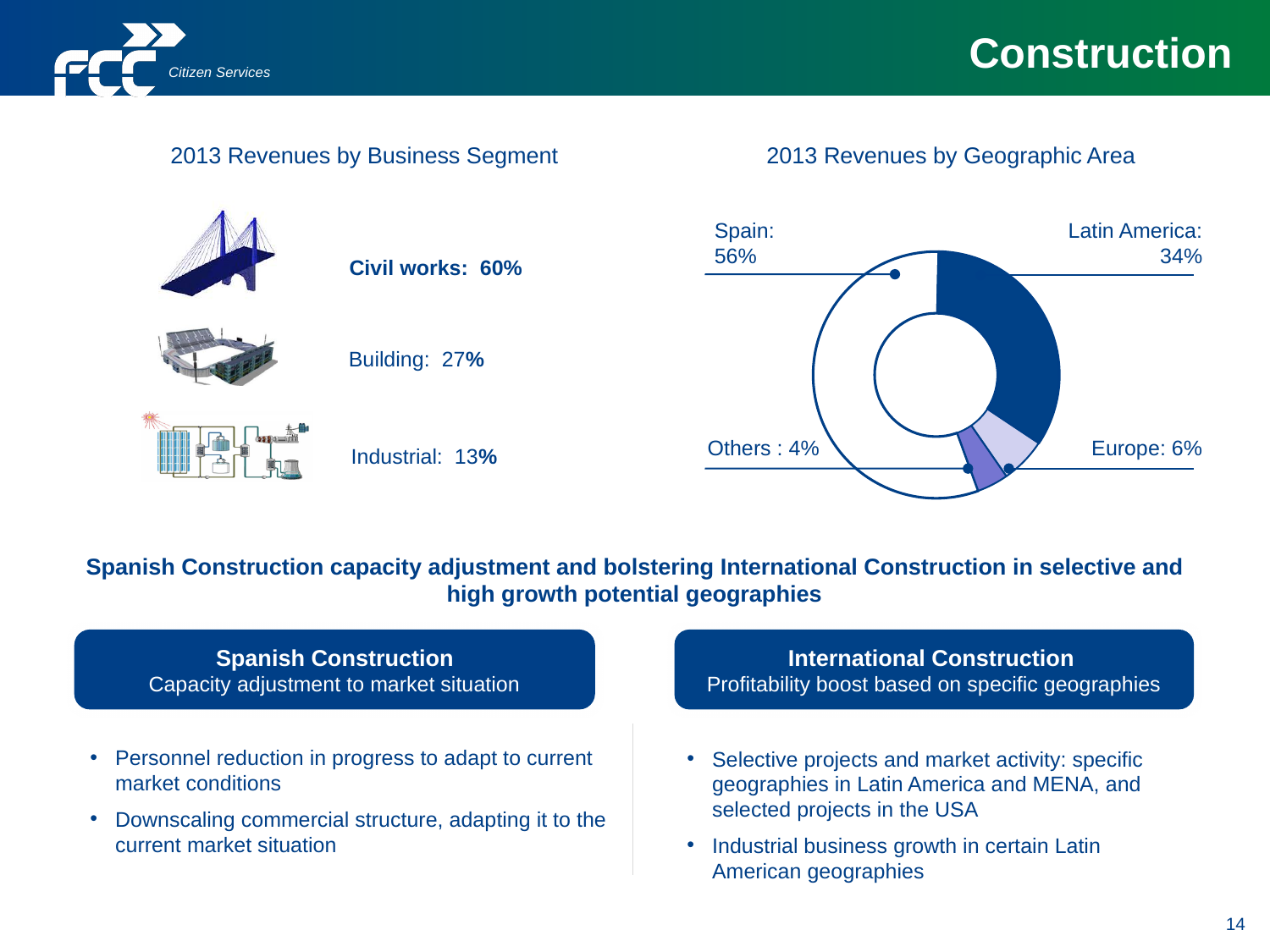
In the 2013 Revenues by Geographic Area chart, what share of revenues comes from Spain? 56% In the 2013 Revenues by Geographic Area chart, which geographic area has the smallest share of revenues? Others What is the title of the chart on the right side of the slide? 2013 Revenues by Geographic Area In the 2013 Revenues by Geographic Area chart, how many geographic areas are shown? 4 In the 2013 Revenues by Geographic Area chart, how many percentage points larger is Spain's share than Latin America's? 22 What kind of chart is used for 2013 Revenues by Geographic Area? Doughnut (pie) chart In the 2013 Revenues by Geographic Area chart, what share of revenues comes from Latin America? 34% In the 2013 Revenues by Geographic Area chart, which geographic area has the largest share of revenues? Spain In the 2013 Revenues by Geographic Area chart, what share of revenues comes from Europe? 6% In the 2013 Revenues by Geographic Area chart, what is the combined share of Europe and Others? 10% In the 2013 Revenues by Geographic Area chart, what share of revenues is labelled Others? 4% In the 2013 Revenues by Geographic Area chart, which is larger, the share for Europe or the share for Others? Europe